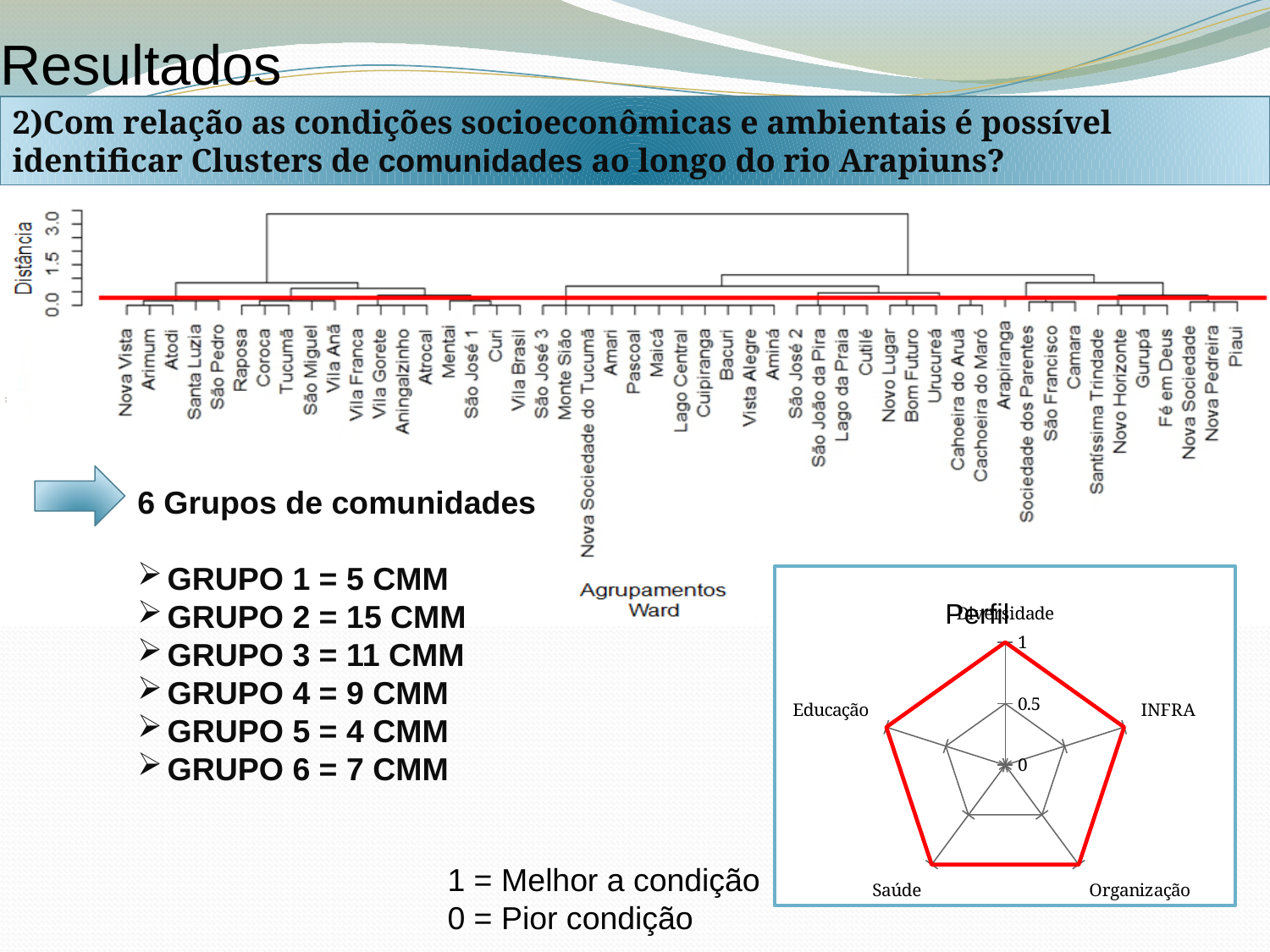
In the "Perfil" radar chart, is the value for Saúde greater or less than 0.5? greater In the "Perfil" radar chart, is the value for Educação greater or less than 0.5? greater How many axes (categories) does the "Perfil" radar chart have? 5 What is the y-axis label of the dendrogram at the top of the slide? Distância In the "Perfil" radar chart, what is the highest tick value shown on the axis scale? 1 In the "Perfil" radar chart, is the value for INFRA greater or less than 0.5? greater In the "Perfil" radar chart, which category is plotted at the top of the chart? Diversidade What kind of chart is the chart titled "Perfil" in the lower right of the slide? radar chart